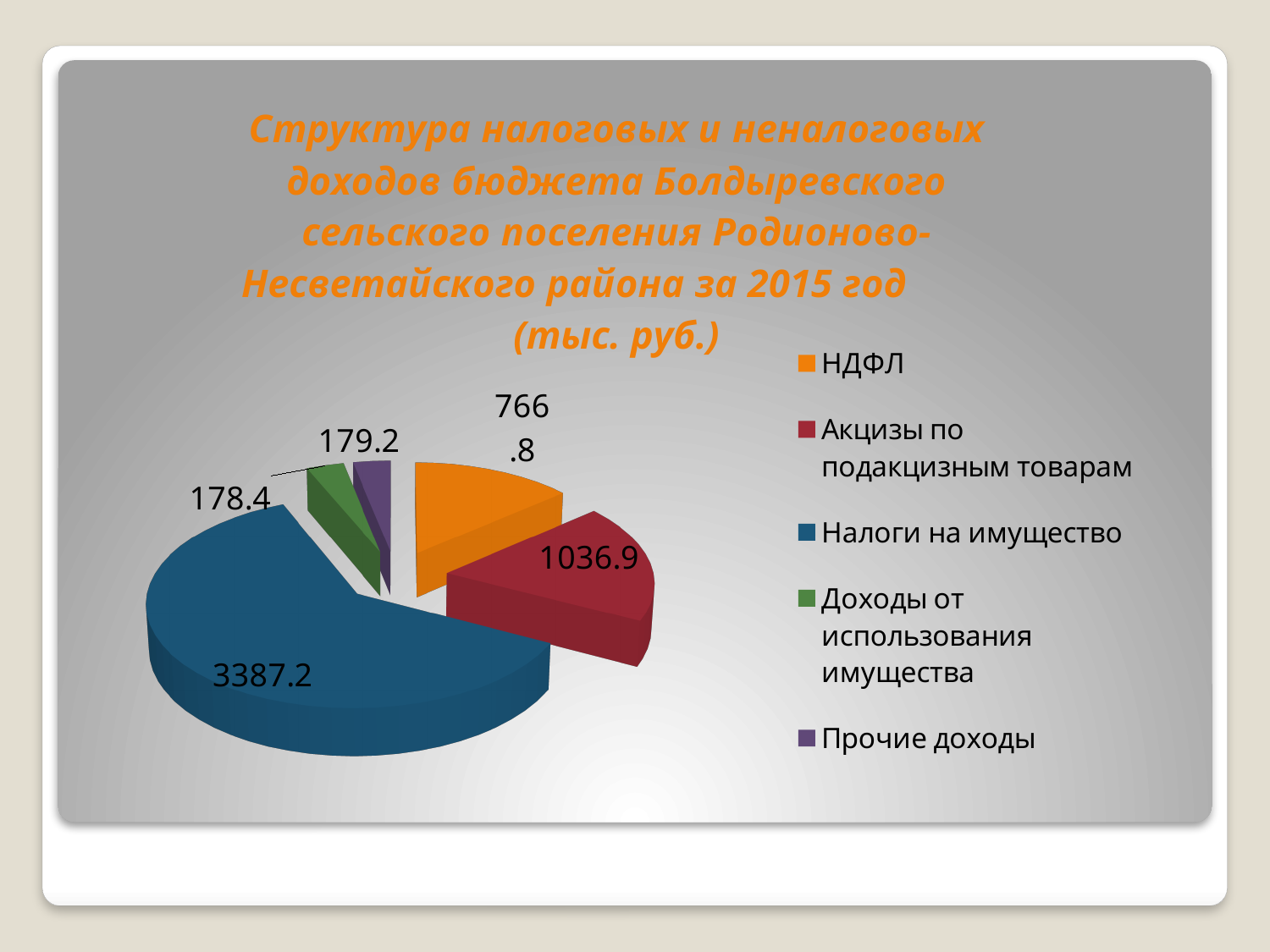
What is the value for Налоги на имущество? 3387.2 What colour is the slice for Налоги на имущество? blue In what units are the values in the chart given, according to the title? тыс. руб. What is the difference between Акцизы по подакцизным товарам and НДФЛ? 270.1 What is the difference between Налоги на имущество and Акцизы по подакцизным товарам? 2350.3 What is the value for НДФЛ? 766.8 What kind of chart is shown on the slide? pie chart Which category has the largest slice of the pie? Налоги на имущество Which is larger, Акцизы по подакцизным товарам or НДФЛ? Акцизы по подакцизным товарам What is the total of all the slices in the pie chart? 5548.5 How many slices does the pie chart have? 5 What is the value for Акцизы по подакцизным товарам? 1036.9